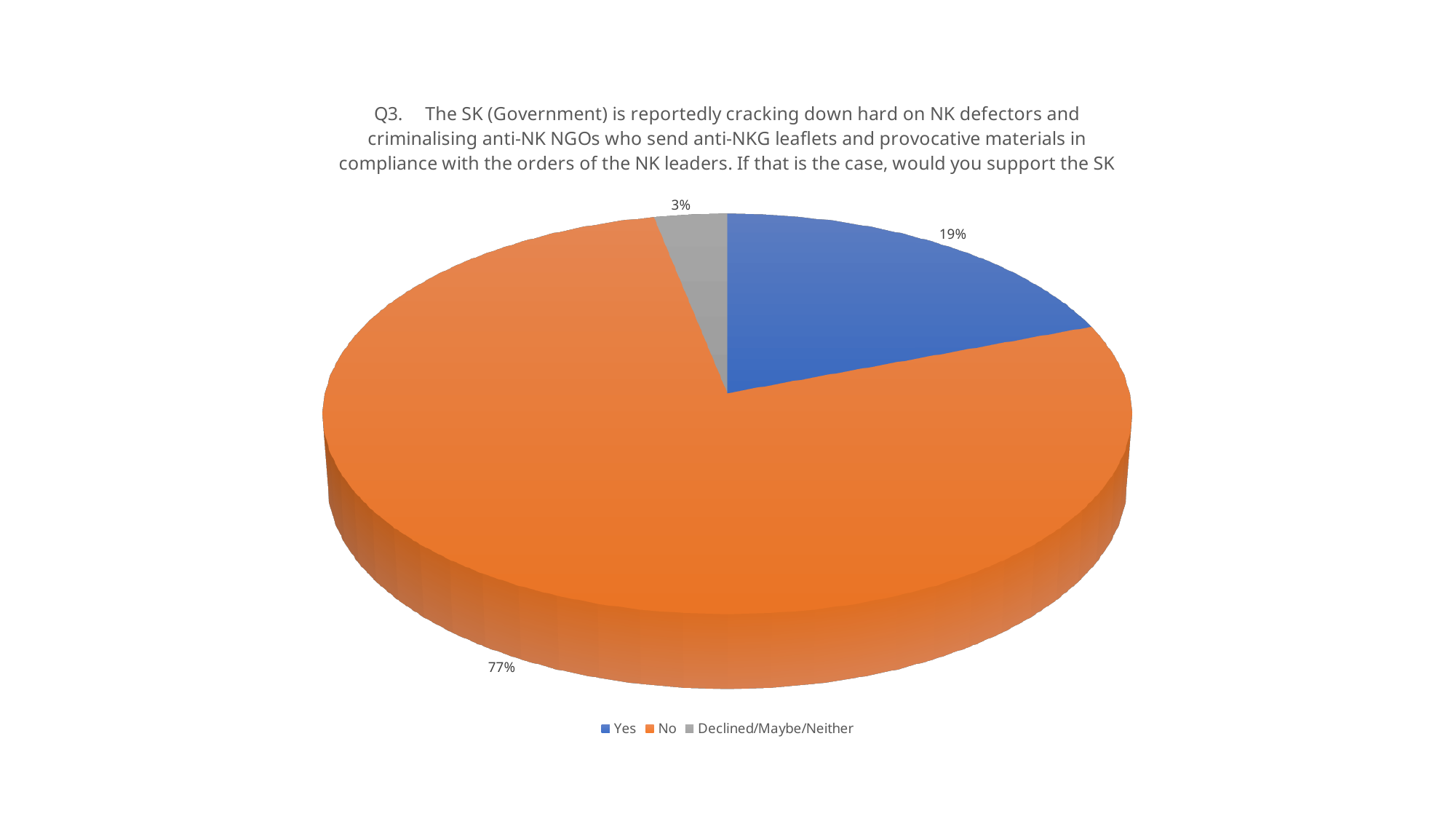
What share of the pie does the "Yes" slice represent? 19% Which category has the smallest slice of the pie? Declined/Maybe/Neither What is the difference in percentage points between the "Yes" and "Declined/Maybe/Neither" slices? 16 What is the difference in percentage points between the "No" and "Yes" slices? 58 What share of the pie does the "No" slice represent? 77% What kind of chart is shown on the slide? pie chart Which is larger, the "Yes" slice or the "Declined/Maybe/Neither" slice? Yes Which colour represents the "No" category in the legend? orange What is the third entry listed in the legend? Declined/Maybe/Neither How many categories does the pie chart have? 3 Which category has the largest slice of the pie? No What share of the pie does the "Declined/Maybe/Neither" slice represent? 3%